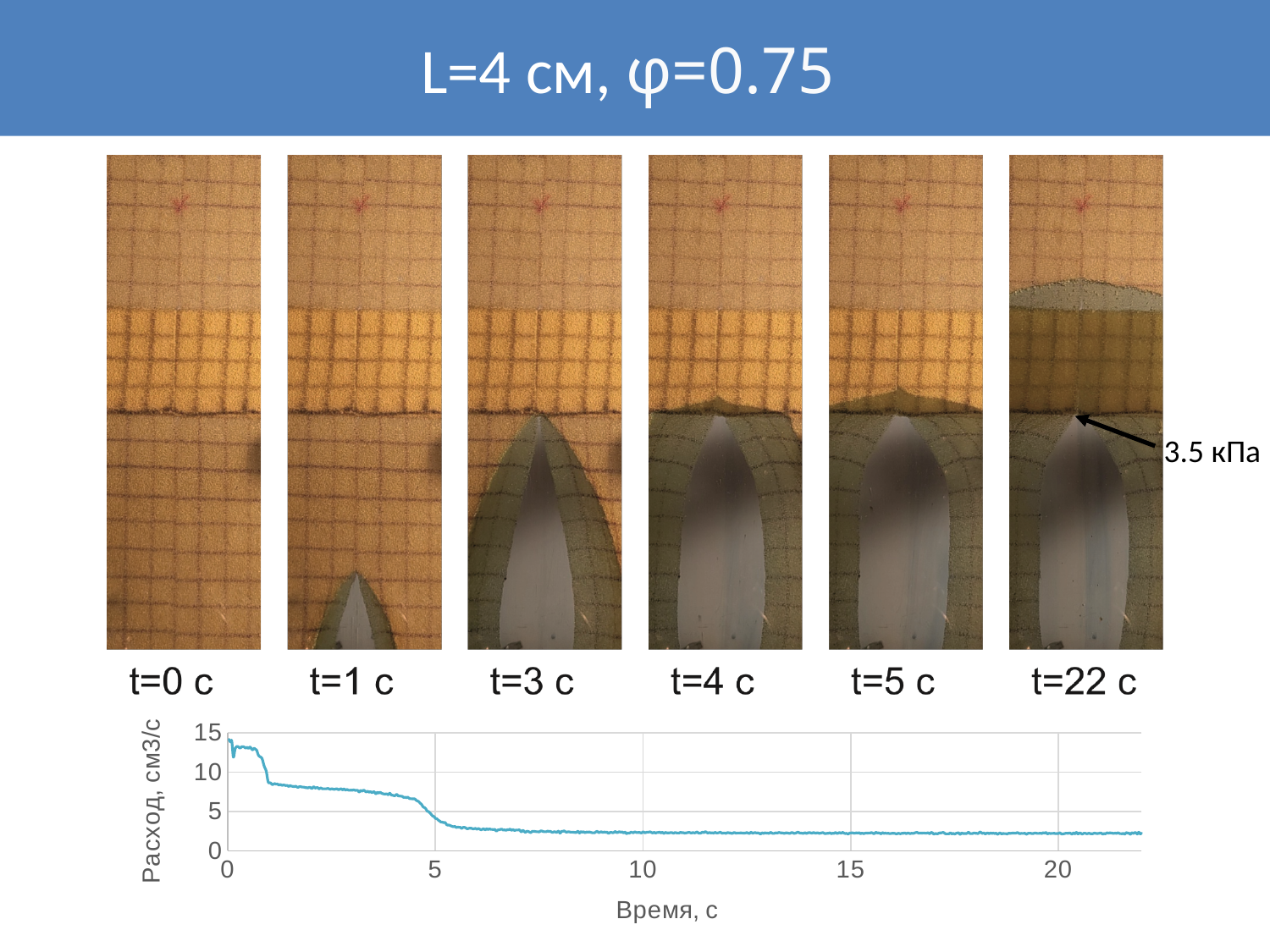
Is the flow rate at time 0.5 с greater or less than 10 см3/с? greater What kind of chart is shown at the bottom of the slide? line chart Is the flow rate at time 2 с greater or less than 5 см3/с? greater What is the highest tick value shown on the y axis of the chart? 15 What is the label of the x axis of the chart? Время, с Is the flow rate at time 15 с greater or less than 5 см3/с? less Does the flow rate (Расход) rise or fall as time increases along the x axis? fall Which is larger, the flow rate at time 2 с or at time 10 с? time 2 с What is the label of the y axis of the chart? Расход, см3/с